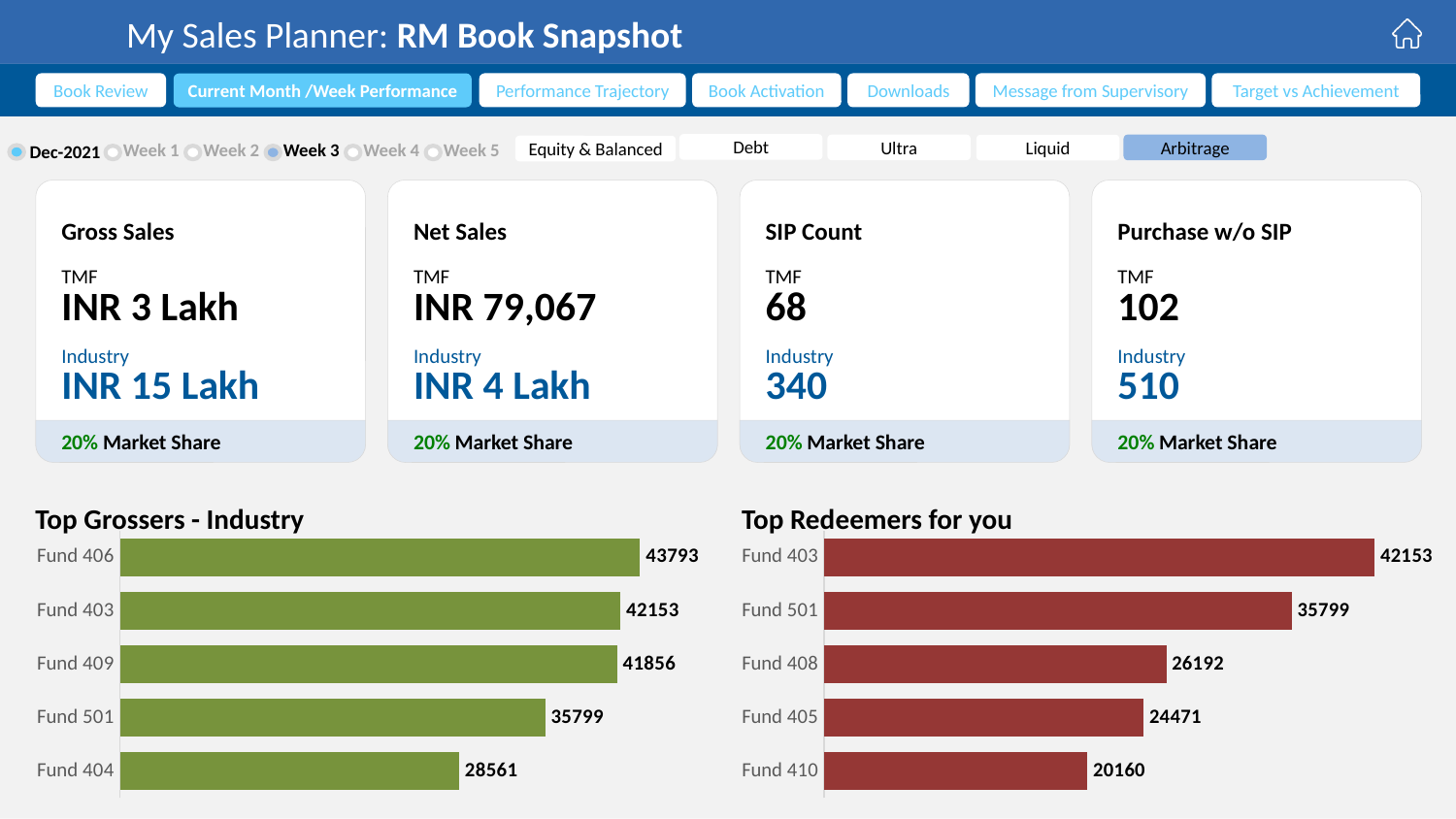
In the 'Top Redeemers for you' chart, which fund has the lowest value? Fund 410 In the 'Top Grossers - Industry' chart, what is the difference between the values for Fund 406 and Fund 404? 15232 In the 'Top Grossers - Industry' chart, which fund has the highest value? Fund 406 In the 'Top Grossers - Industry' chart, what is the value for Fund 404? 28561 How many funds are shown in the 'Top Grossers - Industry' chart? 5 In the 'Top Redeemers for you' chart, what is the value for Fund 408? 26192 In the 'Top Redeemers for you' chart, which is larger, the value for Fund 408 or the value for Fund 405? Fund 408 What colour are the bars in the 'Top Grossers - Industry' chart? Green In the 'Top Grossers - Industry' chart, what is the value for Fund 406? 43793 What kind of chart is 'Top Redeemers for you'? Bar chart In the 'Top Redeemers for you' chart, what is the value for Fund 410? 20160 In the 'Top Redeemers for you' chart, what is the difference between the values for Fund 403 and Fund 501? 6354